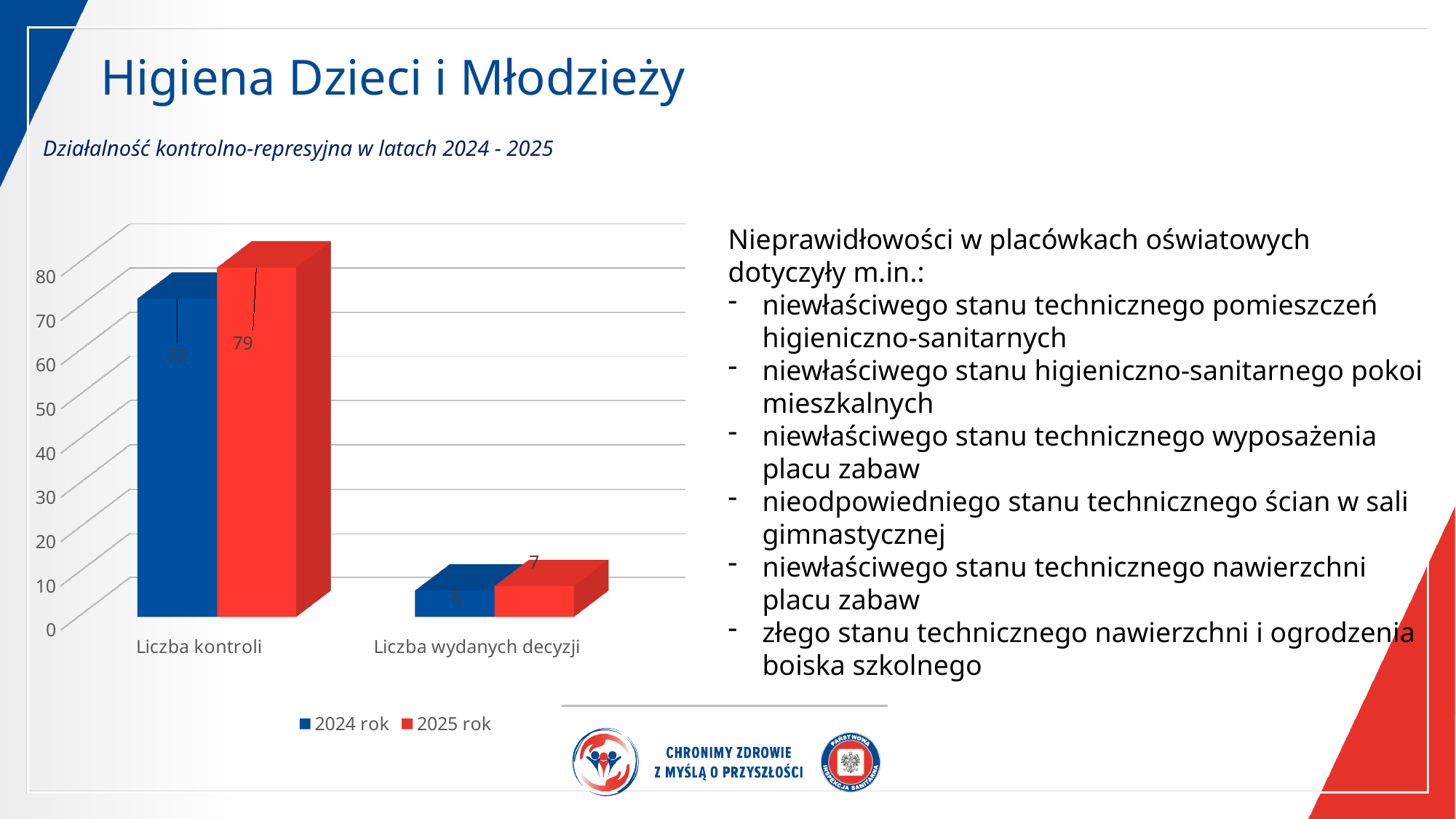
How many categories are shown on the x axis of the chart? 2 What is the value for Liczba kontroli in the 2025 rok series? 79 Which category has the highest value in the 2025 rok series? Liczba kontroli What is the difference between the 2025 rok and 2024 rok values for Liczba kontroli? 7 What kind of chart is shown on the slide? bar chart What is the value for Liczba wydanych decyzji in the 2025 rok series? 7 What is the value for Liczba wydanych decyzji in the 2024 rok series? 6 What is the difference between the 2025 rok and 2024 rok values for Liczba wydanych decyzji? 1 How many series does the chart legend list? 2 What is the value for Liczba kontroli in the 2024 rok series? 72 Which series has the larger value for Liczba kontroli, 2024 rok or 2025 rok? 2025 rok Which category has the lowest value in the 2024 rok series? Liczba wydanych decyzji